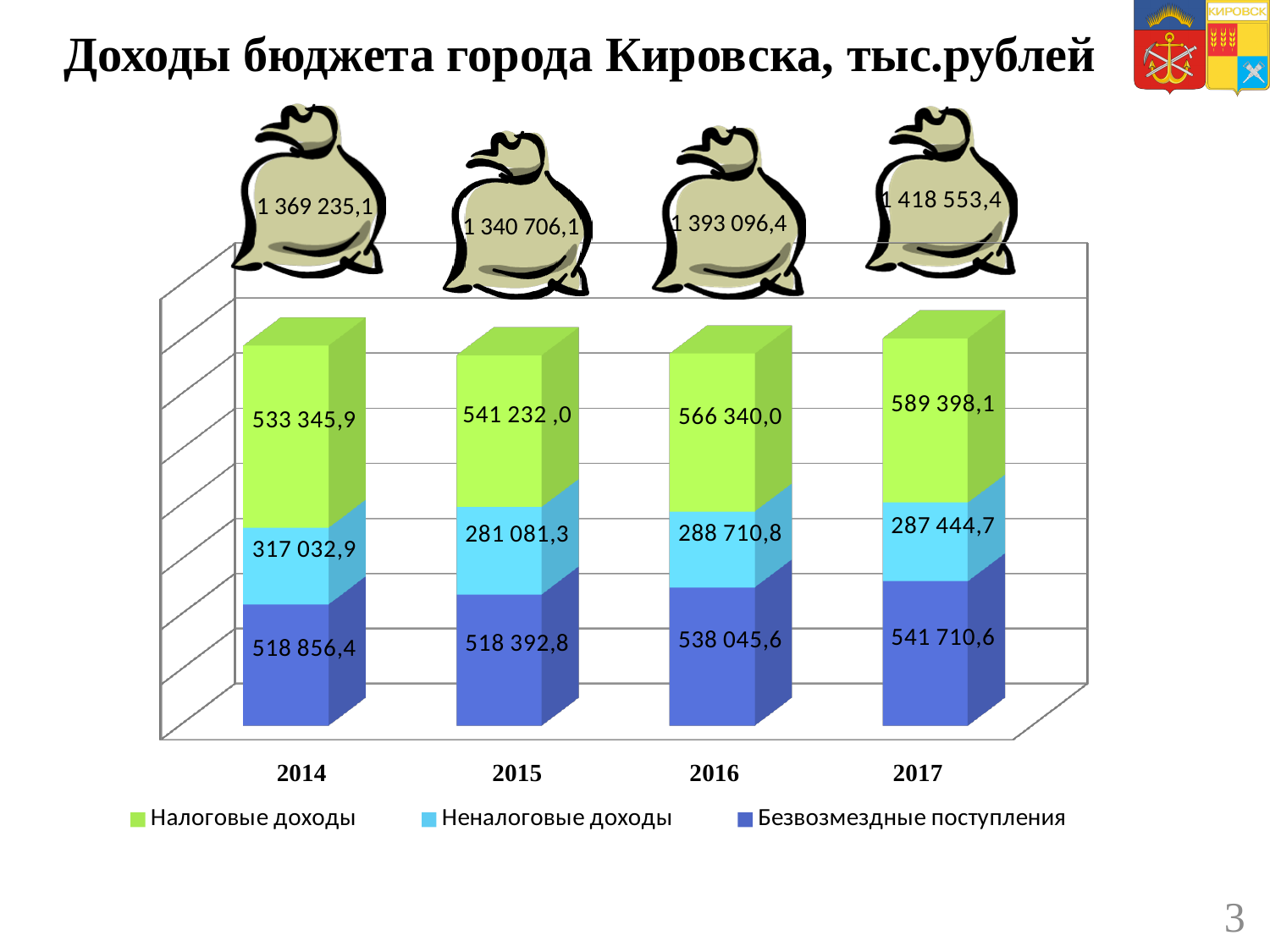
How many years are shown on the x axis of the chart? 4 What is the value of Неналоговые доходы for 2014? 317 032,9 Do Налоговые доходы rise or fall from 2014 to 2017? Rise By how much did Налоговые доходы in 2017 exceed Налоговые доходы in 2014? 56 052,2 In which year are Неналоговые доходы the lowest? 2015 What kind of chart is shown on the slide? Stacked bar chart Which year has the larger value of Безвозмездные поступления, 2015 or 2016? 2016 What is the value of Безвозмездные поступления for 2017? 541 710,6 What is the value of Налоговые доходы for 2016? 566 340,0 How many series does the legend list? 3 In which year are Налоговые доходы the highest? 2017 What is the total budget income shown for 2017? 1 418 553,4